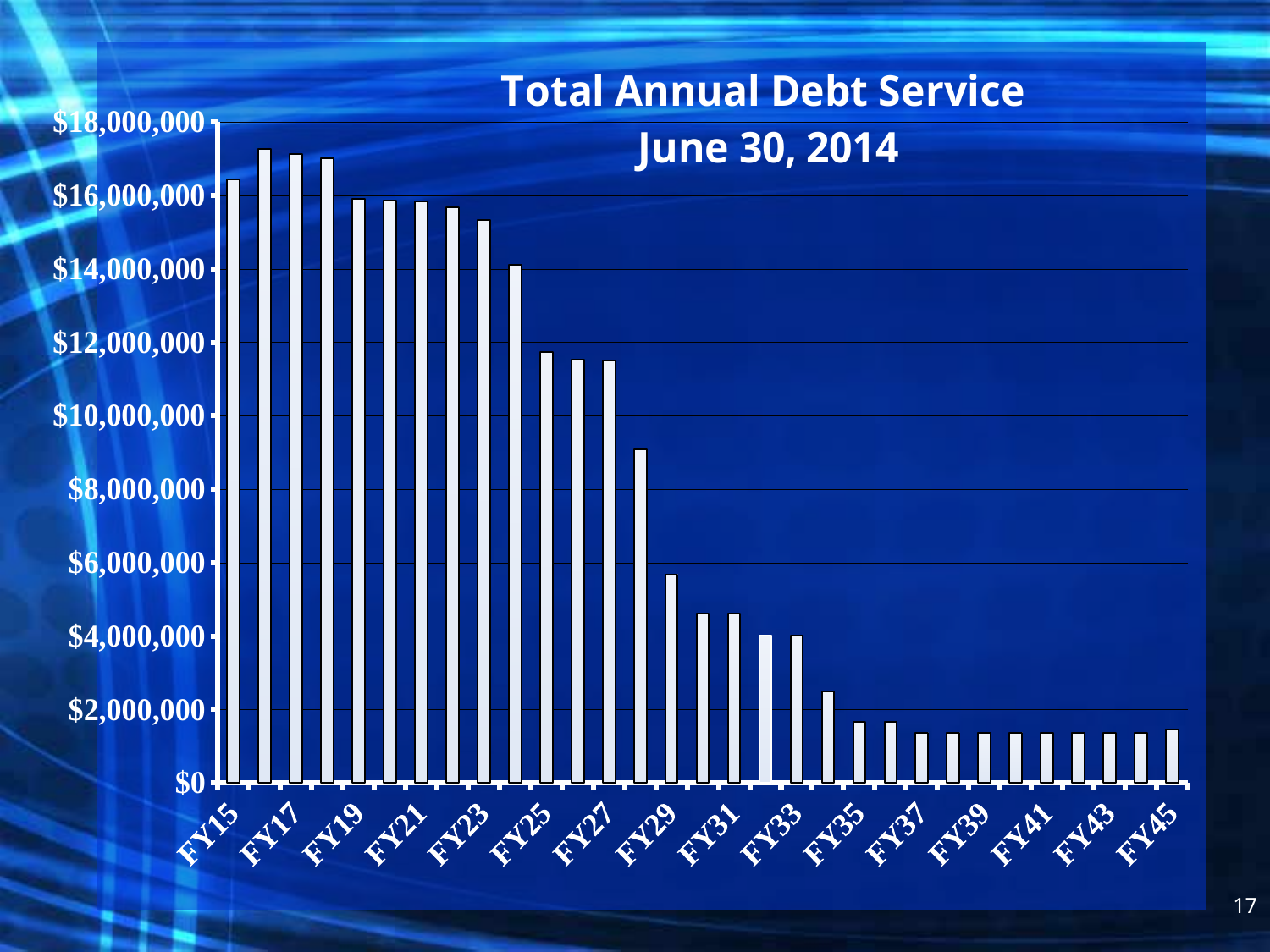
Is the value for FY27 greater or less than $10,000,000? greater Is the value for FY17 greater or less than $16,000,000? greater Do the values generally rise or fall from FY15 to FY45? Fall What kind of chart is shown on the slide? Bar chart Is the value for FY35 greater or less than $2,000,000? less Which is larger, the value for FY39 or the value for FY25? FY25 How many bars are plotted in the chart? 31 What is the title of the chart? Total Annual Debt Service June 30, 2014 Which is larger, the value for FY15 or the value for FY29? FY15